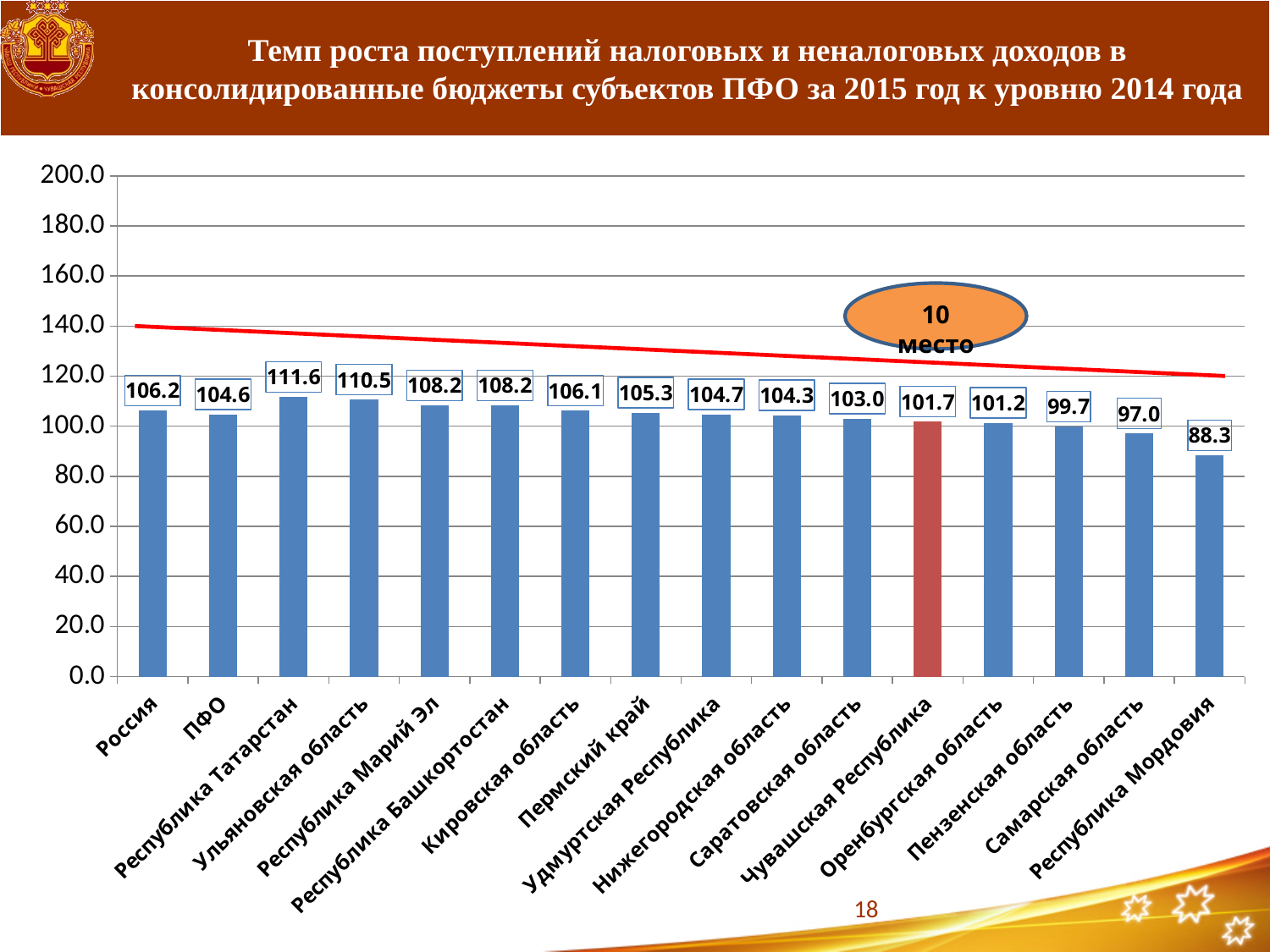
How many categories are shown on the x axis? 16 What is the value for Чувашская Республика? 101.7 Is the value for Пензенская область greater or less than 100.0? less What is the value for Самарская область? 97.0 Which category has the lowest value? Республика Мордовия What is the difference between the values for Республика Татарстан and Республика Мордовия? 23.3 What kind of chart is shown on the slide? bar chart Which category's bar is coloured red instead of blue? Чувашская Республика Which is larger, the value for Ульяновская область or the value for Пермский край? Ульяновская область What is the value for Республика Татарстан? 111.6 Which category has the highest value? Республика Татарстан What is the value for Россия? 106.2